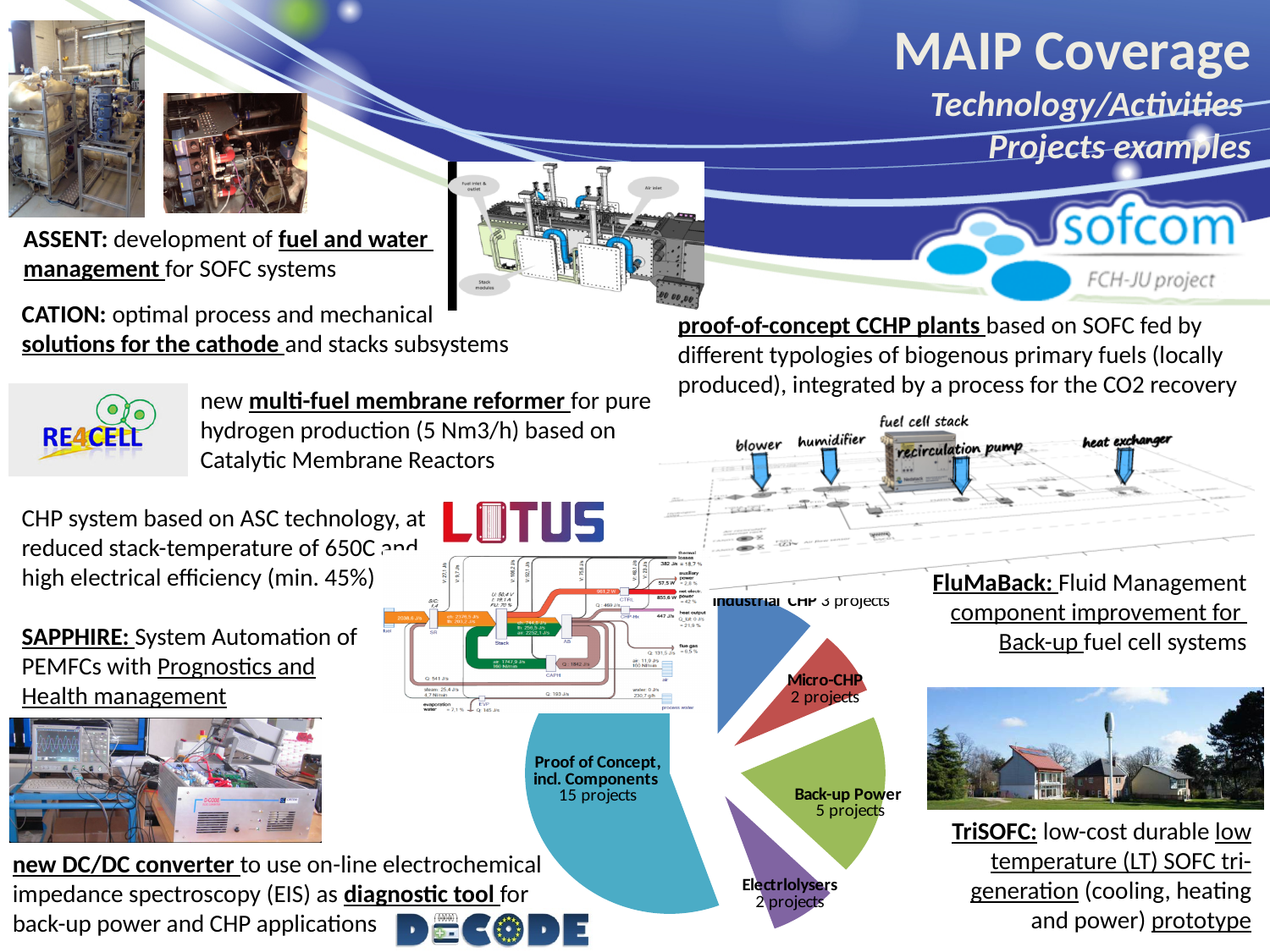
Which category has the largest slice in the pie chart? Proof of Concept, incl. Components What is the total number of projects across all slices of the pie chart? 27 How many projects does the pie chart show for Micro-CHP? 2 projects How many projects does the pie chart show for Industrial CHP? 3 projects Which has more projects in the pie chart, Back-up Power or Industrial CHP? Back-up Power How many categories (slices) does the pie chart have? 5 Which two categories in the pie chart have the fewest projects? Micro-CHP and Electrolysers How many more projects are in Proof of Concept, incl. Components than in Back-up Power? 10 How many projects does the pie chart show for Back-up Power? 5 projects How many projects does the pie chart show for Electrolysers? 2 projects How many projects does the pie chart show for Proof of Concept, incl. Components? 15 projects What kind of chart is shown at the bottom centre of the slide? pie chart